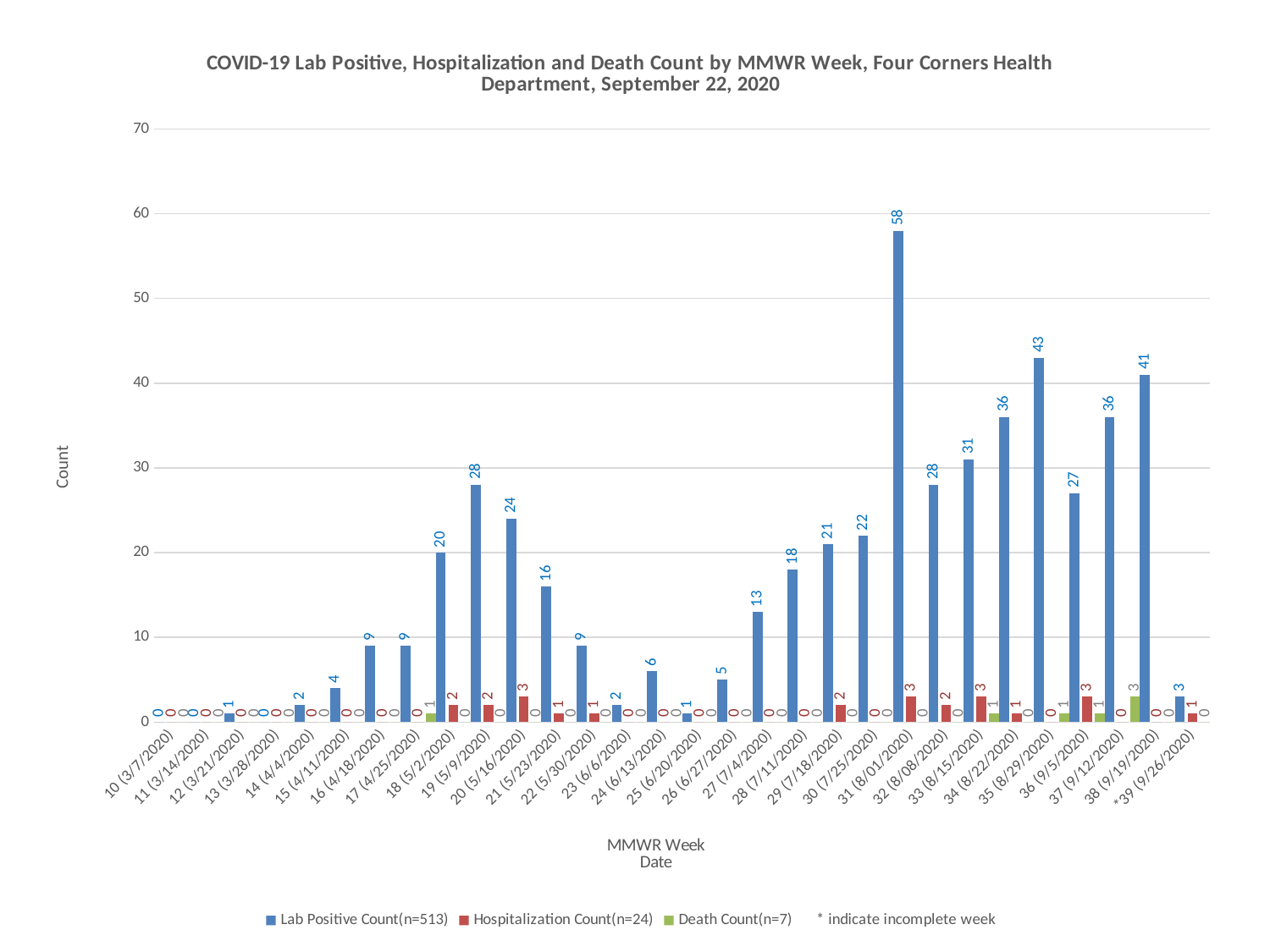
Which MMWR week has the highest Lab Positive Count? 31 (8/01/2020) Which is larger, the Lab Positive Count for week 19 (5/9/2020) or week 20 (5/16/2020)? 19 (5/9/2020) What is the Death Count for MMWR week 37 (9/12/2020)? 3 How many series does the legend list? 3 Does the Lab Positive Count rise or fall from week 27 (7/4/2020) to week 31 (8/01/2020)? rise What is the Hospitalization Count for MMWR week 20 (5/16/2020)? 3 How many MMWR weeks are shown on the x axis? 30 Is the Lab Positive Count for week 38 (9/19/2020) greater or less than 40? greater According to the legend, what is the total n for the Hospitalization Count series? 24 What kind of chart is shown on the slide? bar chart What is the Lab Positive Count for MMWR week 31 (8/01/2020)? 58 What is the difference between the Lab Positive Count for week 35 (8/29/2020) and week 36 (9/5/2020)? 16